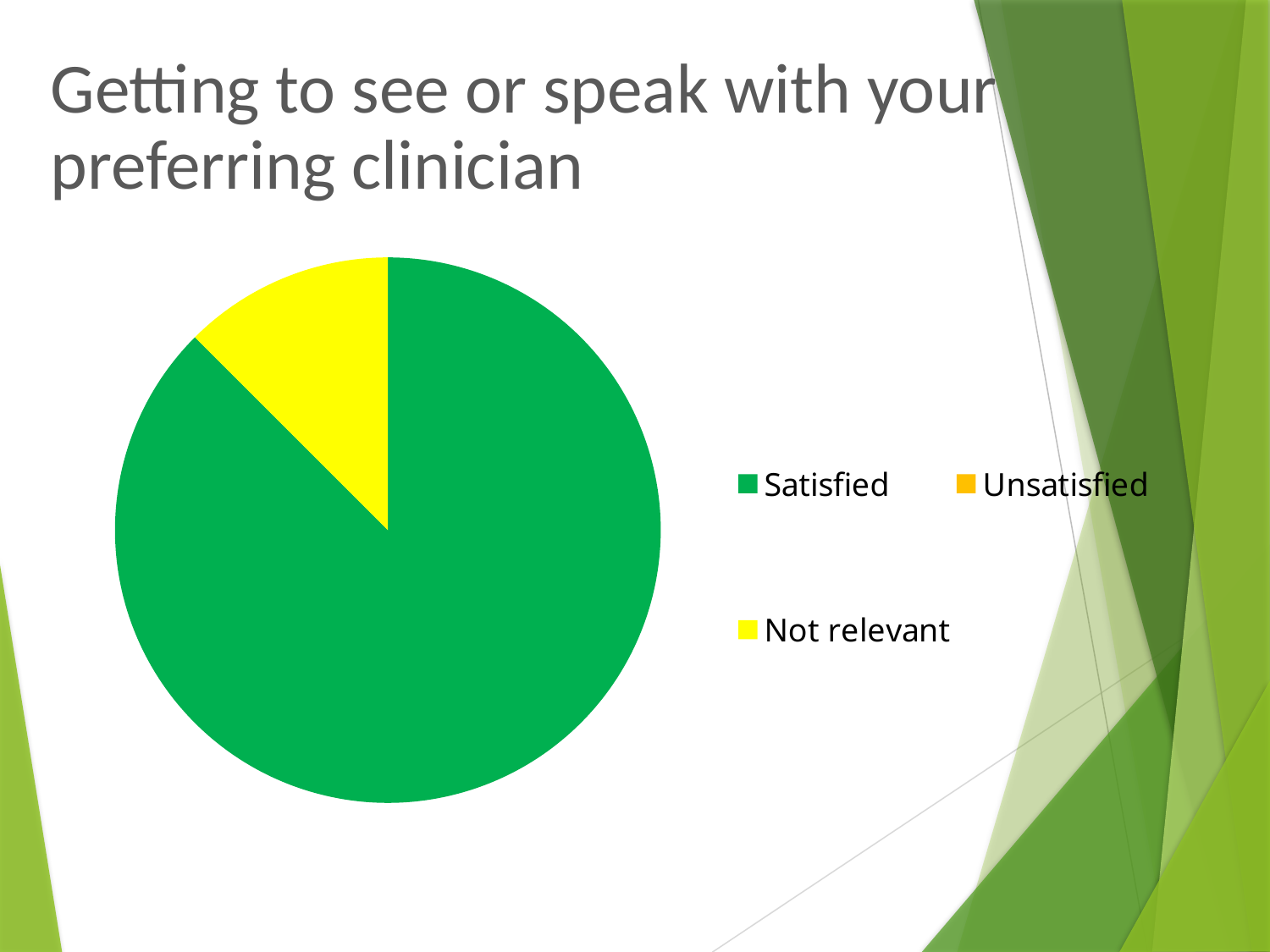
How many slices are visible in the pie chart? 2 How many entries does the legend of the pie chart list? 3 Which is larger in the pie chart, the Satisfied slice or the Not relevant slice? Satisfied Which category has the largest slice of the pie chart? Satisfied What kind of chart is shown on the slide? Pie chart What is the title of the slide containing the pie chart? Getting to see or speak with your preferring clinician What colour represents the Satisfied category in the pie chart? Green Which legend category has no visible slice in the pie chart? Unsatisfied